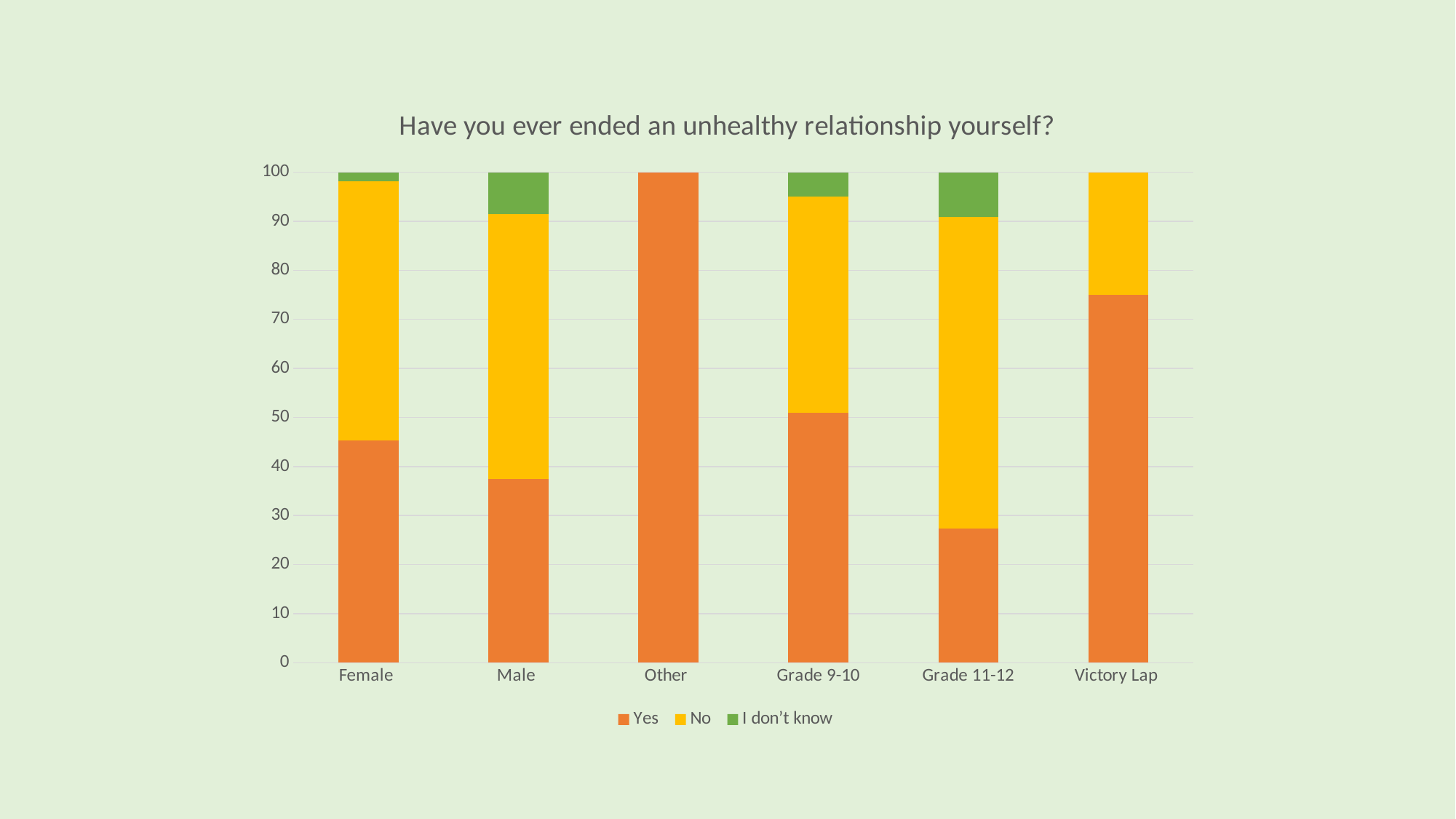
Which has a larger 'Yes' value, Female or Male? Female How many series does the legend list? 3 What kind of chart is shown on the slide? Stacked bar chart Which category has the lowest 'Yes' value? Grade 11-12 Which colour represents the 'I don't know' series? Green Is the 'Yes' value for Female greater or less than 40? greater How many categories are shown along the x axis? 6 Which category has the highest 'Yes' value? Other What is the 'Yes' value for Other? 100 What is the title of the chart? Have you ever ended an unhealthy relationship yourself? What is the total of the stacked bar for Male? 100 Is the 'Yes' value for Grade 11-12 greater or less than 30? less